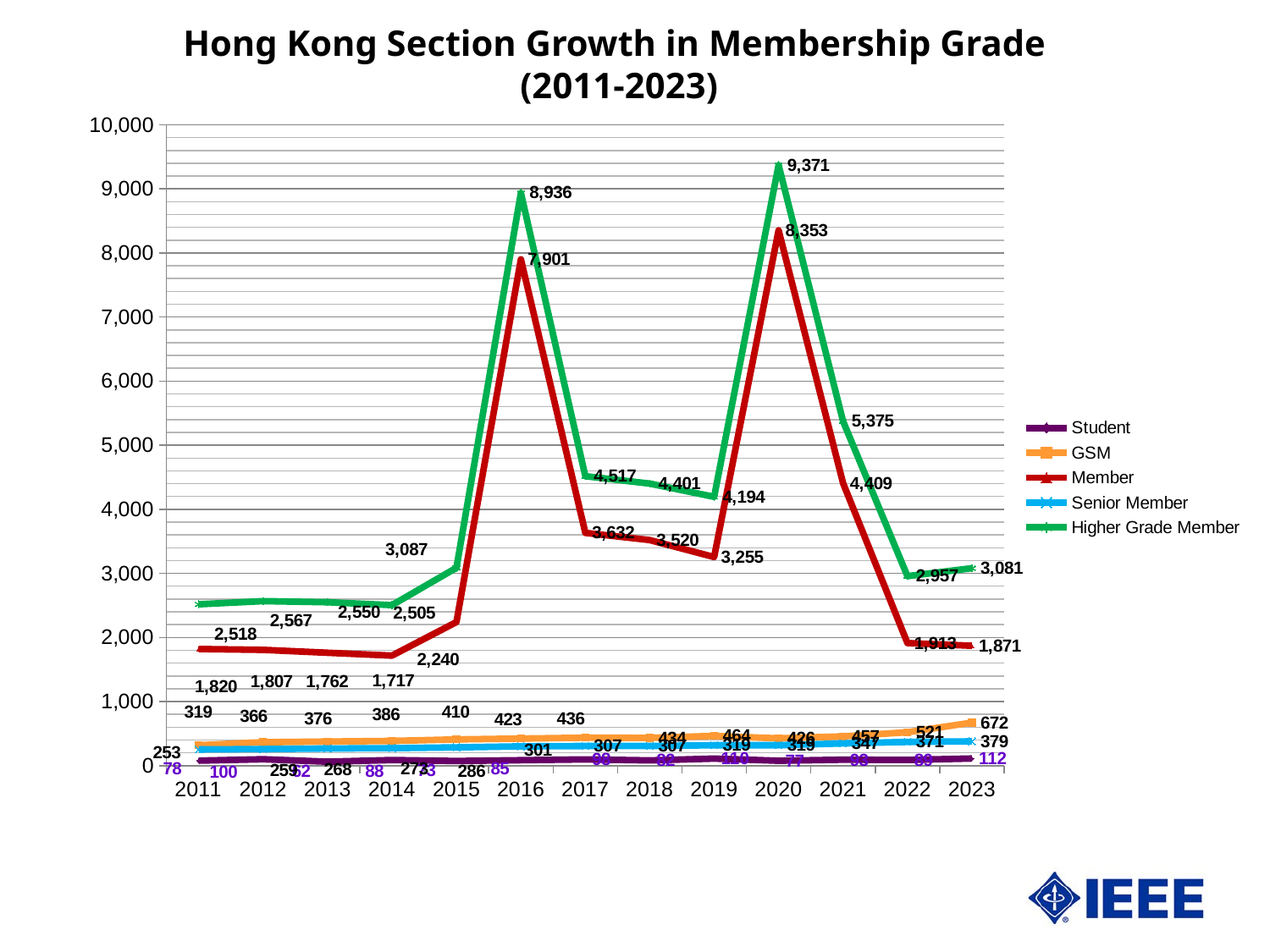
What is the value for Senior Member in 2023? 379 What is the value for Member in 2016? 7,901 Which year has the larger Member value, 2016 or 2020? 2020 In which year does the Member series have its lowest value? 2014 What is the value for GSM in 2023? 672 How many series does the legend list? 5 What kind of chart is shown on the slide? line chart Is the value for Higher Grade Member in 2021 greater or less than 5,000? greater What is the difference between the Higher Grade Member values in 2020 and 2016? 435 In which year does the Higher Grade Member series reach its highest value? 2020 What is the value for Higher Grade Member in 2020? 9,371 What is the difference between the Member values in 2022 and 2023? 42